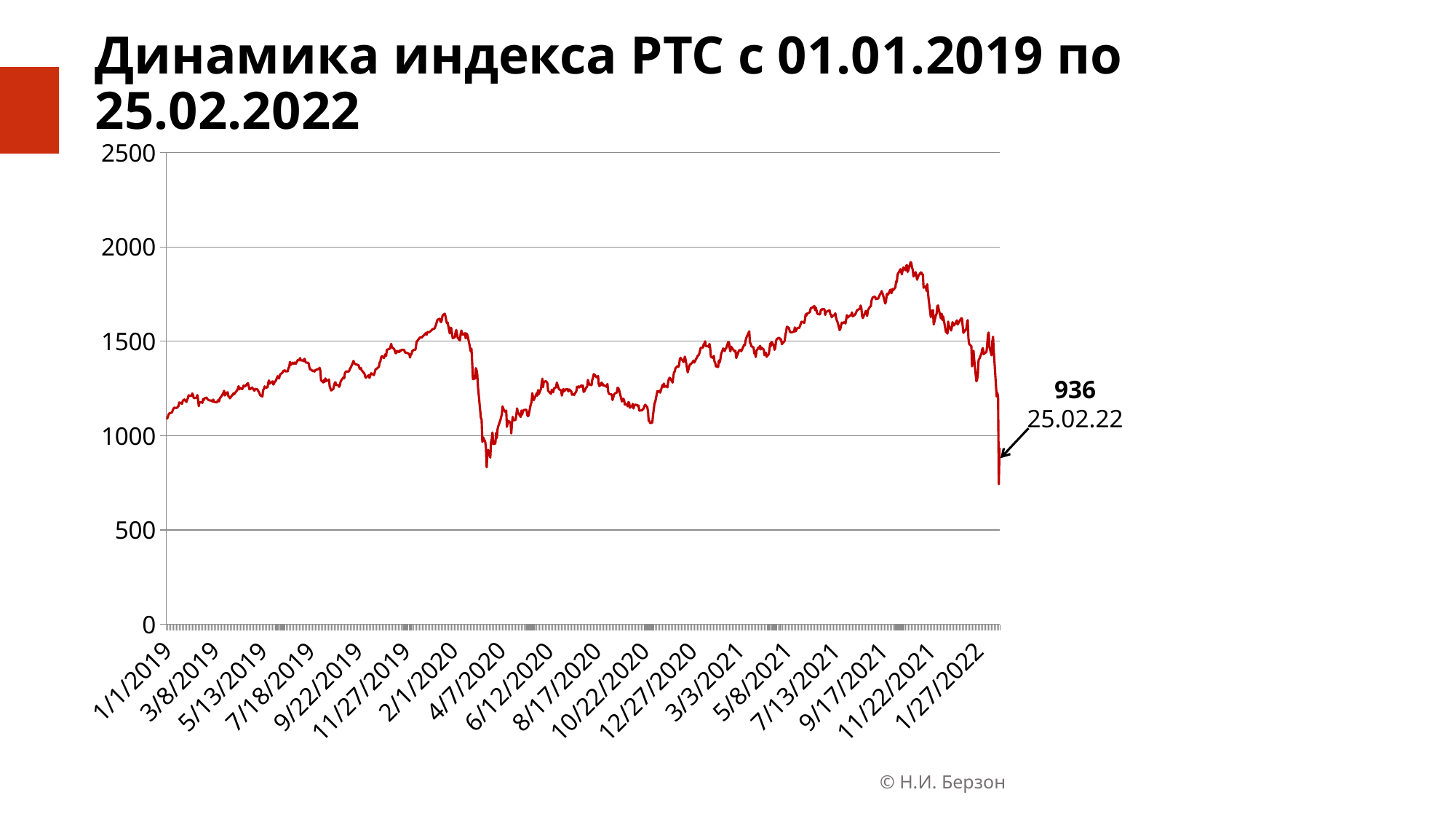
Is the value of the RTS index at its dip around 4/7/2020 greater or less than 1000? less What kind of chart is shown on the slide? line chart How many date labels are shown on the x axis? 18 Does the RTS index rise or fall between 11/22/2021 and the end of the chart? fall Does the RTS index overall rise or fall between 4/7/2020 and 11/22/2021? rise Is the value of the RTS index at 1/1/2019 greater or less than 1000? greater What is the highest value shown on the y axis? 2500 Is the highest point of the RTS index, reached in late 2021, greater or less than 2000? less What value of the RTS index is labelled on the chart for 25.02.22? 936 What is the title of the chart? Динамика индекса РТС с 01.01.2019 по 25.02.2022 Which date is annotated with a data label on the chart? 25.02.22